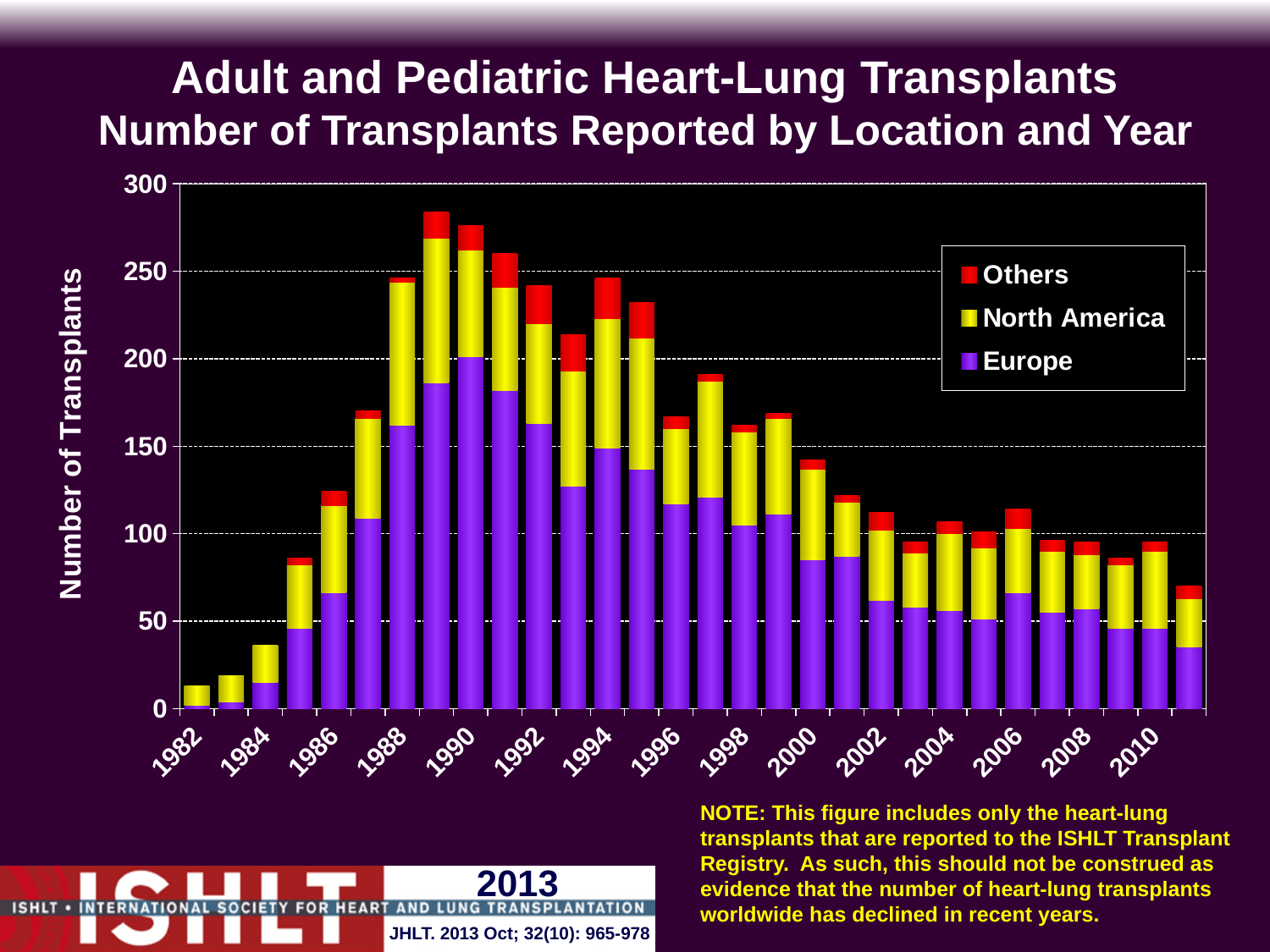
Is the total number of transplants in 2011 greater or less than 50? greater How many series does the legend list? 3 Which year has a larger total number of transplants, 1994 or 1995? 1994 Which year has the highest total number of heart-lung transplants? 1989 Is the total number of transplants in 1982 greater or less than 50? less Which year has the lowest total number of heart-lung transplants? 1982 Do the total numbers of transplants generally rise or fall from 1989 to 2011? fall Is the total number of transplants in 2000 greater or less than 150? less Which colour represents Europe in the chart? Purple What kind of chart is shown on the slide? Stacked bar chart